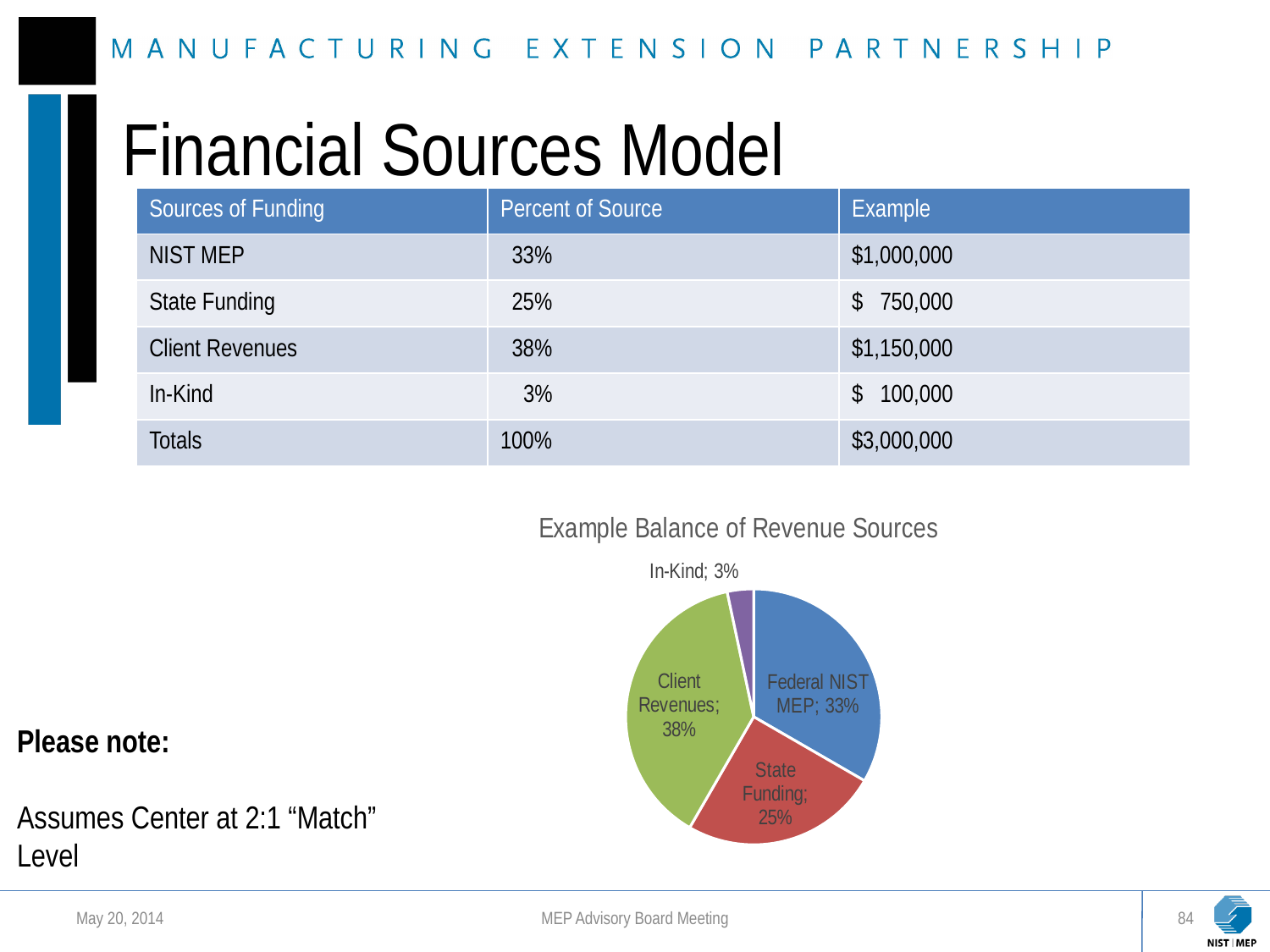
What share of the pie does Client Revenues represent? 38% How many slices does the pie chart have? 4 What share of the pie does In-Kind represent? 3% Which revenue source has the largest slice of the pie? Client Revenues What colour is the Client Revenues slice? green What type of chart is shown on the slide? pie chart Which revenue source has the smallest slice of the pie? In-Kind What share of the pie does Federal NIST MEP represent? 33% Which is larger, the Federal NIST MEP slice or the State Funding slice? Federal NIST MEP What is the title of the chart? Example Balance of Revenue Sources What is the difference in percentage points between Client Revenues and State Funding? 13